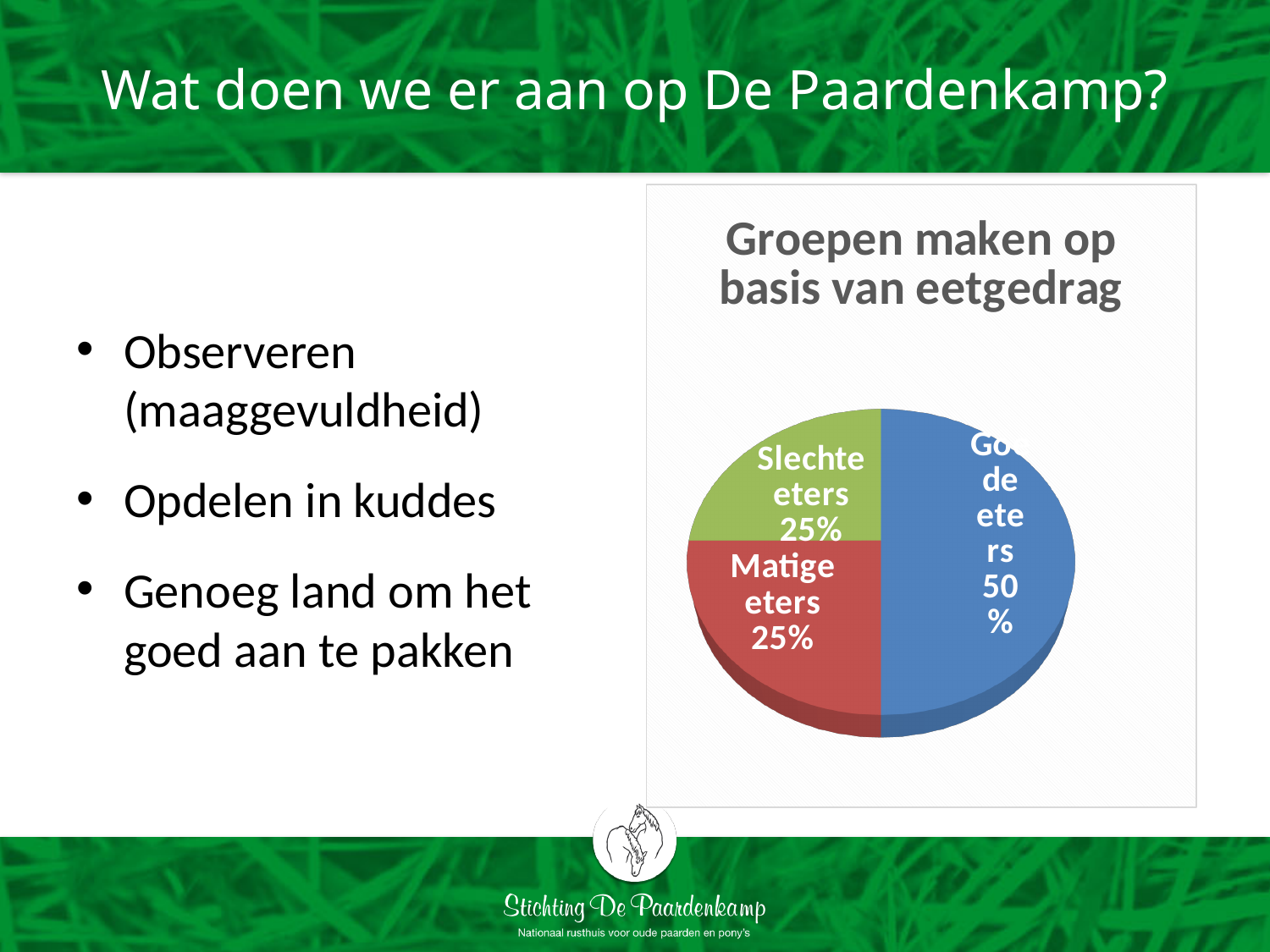
Which is larger, the slice for Goede eters or the slice for Matige eters? Goede eters How many slices does the pie chart have? 3 Is the share for Slechte eters greater or less than 50%? less What share of the pie is labelled Goede eters? 50% Which category has the largest slice of the pie? Goede eters What is the difference between the share for Goede eters and the share for Slechte eters? 25% What share of the pie is labelled Matige eters? 25% What colour is the Goede eters slice? blue What share of the pie is labelled Slechte eters? 25% What kind of chart is shown on the slide? pie chart What is the title of the chart? Groepen maken op basis van eetgedrag